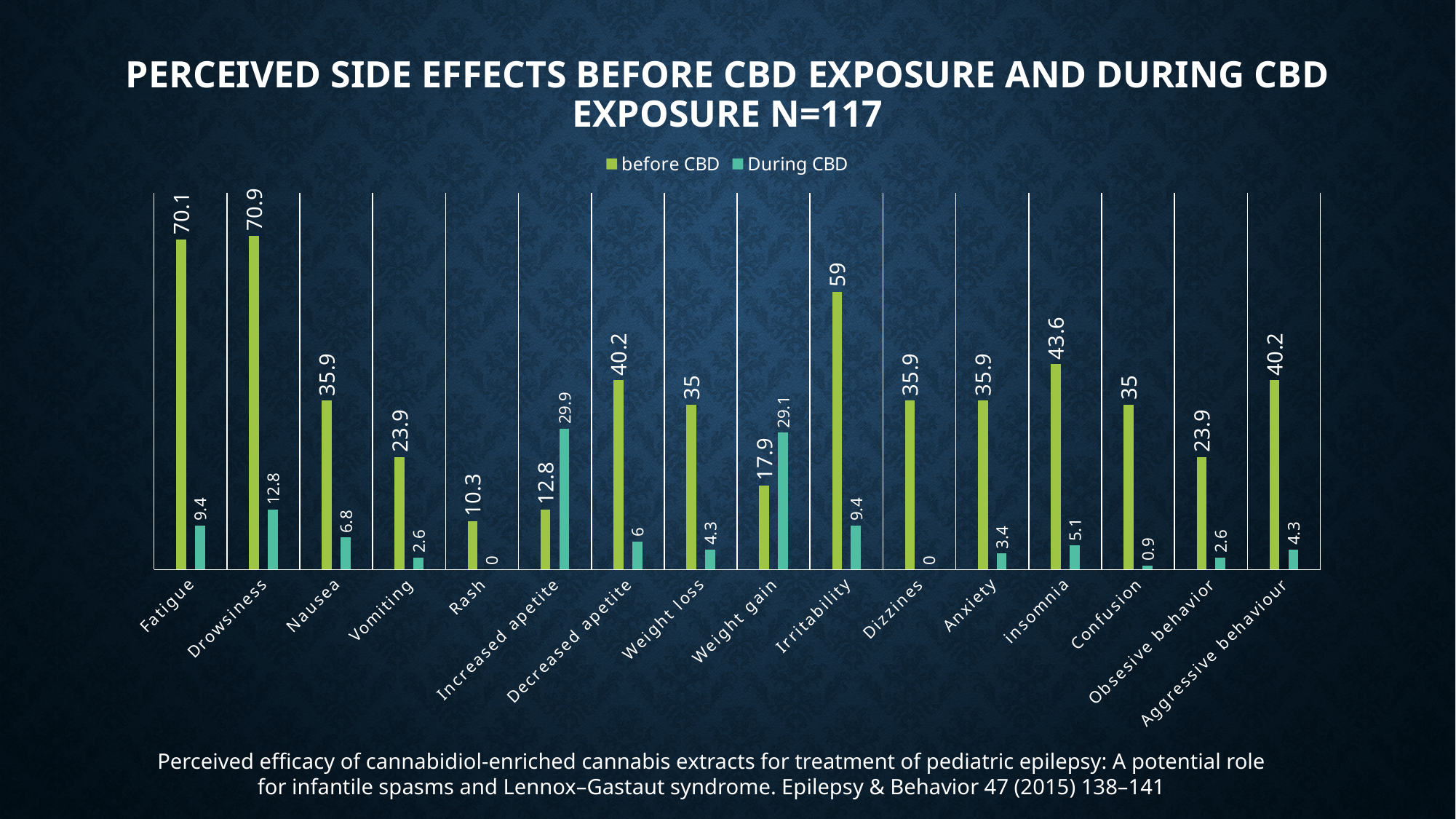
What is the During CBD value for Increased apetite? 29.9 Which category has the highest before CBD value? Drowsiness What is the During CBD value for Confusion? 0.9 Which category has the lowest before CBD value? Rash How many series does the legend list? 2 How many side-effect categories are shown on the x axis? 16 What is the difference between the before CBD and During CBD values for Fatigue? 60.7 What kind of chart is shown on the slide? Bar chart For Weight gain, which is larger: the before CBD value or the During CBD value? During CBD Which category has the highest During CBD value? Increased apetite What is the difference between the before CBD and During CBD values for Irritability? 49.6 What is the before CBD value for Fatigue? 70.1